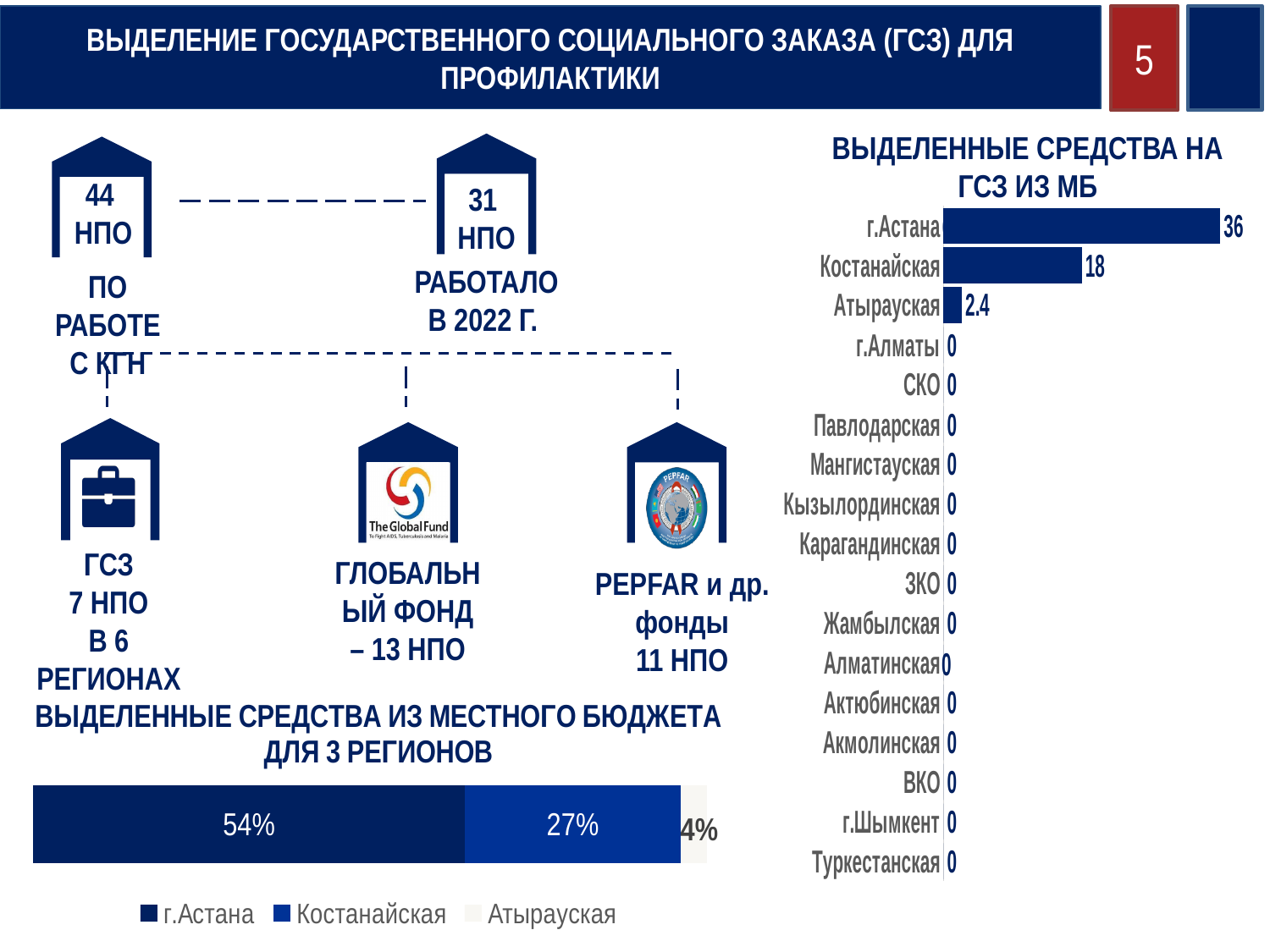
In the chart titled 'ВЫДЕЛЕННЫЕ СРЕДСТВА НА ГСЗ ИЗ МБ', how many regions are listed? 17 In the chart titled 'ВЫДЕЛЕННЫЕ СРЕДСТВА НА ГСЗ ИЗ МБ', what is the value for Атырауская? 2.4 In the chart titled 'ВЫДЕЛЕННЫЕ СРЕДСТВА НА ГСЗ ИЗ МБ', which region has the highest value? г.Астана In the chart titled 'ВЫДЕЛЕННЫЕ СРЕДСТВА НА ГСЗ ИЗ МБ', what is the difference between the values for г.Астана and Костанайская? 18 In the chart titled 'ВЫДЕЛЕННЫЕ СРЕДСТВА НА ГСЗ ИЗ МБ', which is larger, the value for Костанайская or the value for Атырауская? Костанайская In the chart titled 'ВЫДЕЛЕННЫЕ СРЕДСТВА НА ГСЗ ИЗ МБ', what is the value for г.Астана? 36 In the chart titled 'ВЫДЕЛЕННЫЕ СРЕДСТВА ИЗ МЕСТНОГО БЮДЖЕТА ДЛЯ 3 РЕГИОНОВ', what is the value for г.Астана? 54% What kind of chart is the chart titled 'ВЫДЕЛЕННЫЕ СРЕДСТВА НА ГСЗ ИЗ МБ'? Bar chart In the chart titled 'ВЫДЕЛЕННЫЕ СРЕДСТВА ИЗ МЕСТНОГО БЮДЖЕТА ДЛЯ 3 РЕГИОНОВ', what is the value for Костанайская? 27% In the chart titled 'ВЫДЕЛЕННЫЕ СРЕДСТВА ИЗ МЕСТНОГО БЮДЖЕТА ДЛЯ 3 РЕГИОНОВ', how many series does the legend list? 3 In the chart titled 'ВЫДЕЛЕННЫЕ СРЕДСТВА НА ГСЗ ИЗ МБ', what is the value for Костанайская? 18 In the chart titled 'ВЫДЕЛЕННЫЕ СРЕДСТВА ИЗ МЕСТНОГО БЮДЖЕТА ДЛЯ 3 РЕГИОНОВ', which series has the smallest value? Атырауская